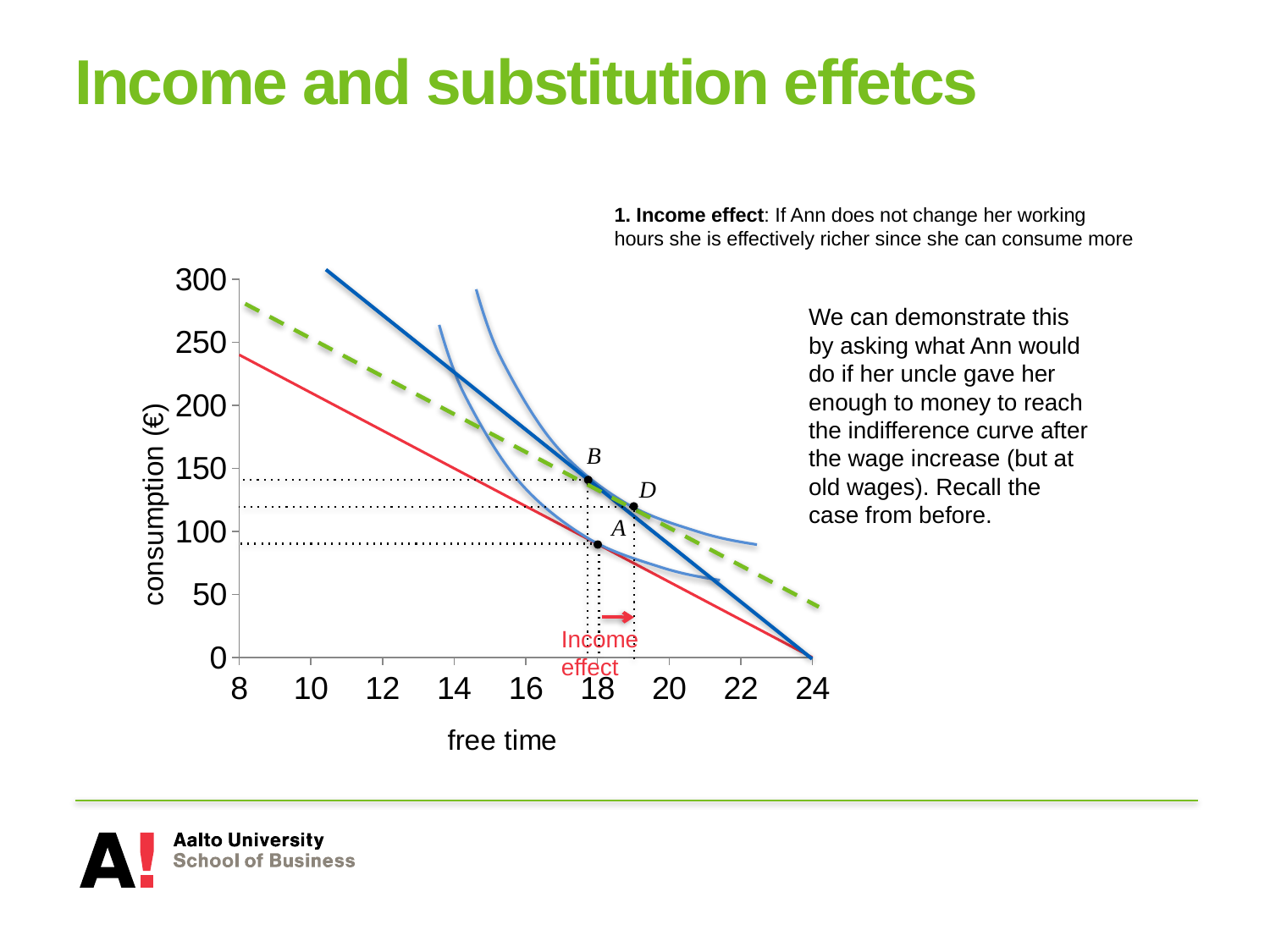
What is the label of the vertical axis of the chart? consumption (€) Which labelled point has the highest consumption? B What kind of chart is shown on the slide? line chart What is the label of the horizontal axis of the chart? free time Is the consumption at point A greater or less than 150? less Is the consumption at point B greater or less than 100? greater Which point has higher consumption, B or D? B Which point has higher consumption, A or D? D Is the free time at point D greater or less than 18? greater Which labelled point has the lowest consumption? A How many labelled points (A, B, D) are marked on the chart? 3 At what free time value do the red and blue budget lines meet the horizontal axis? 24